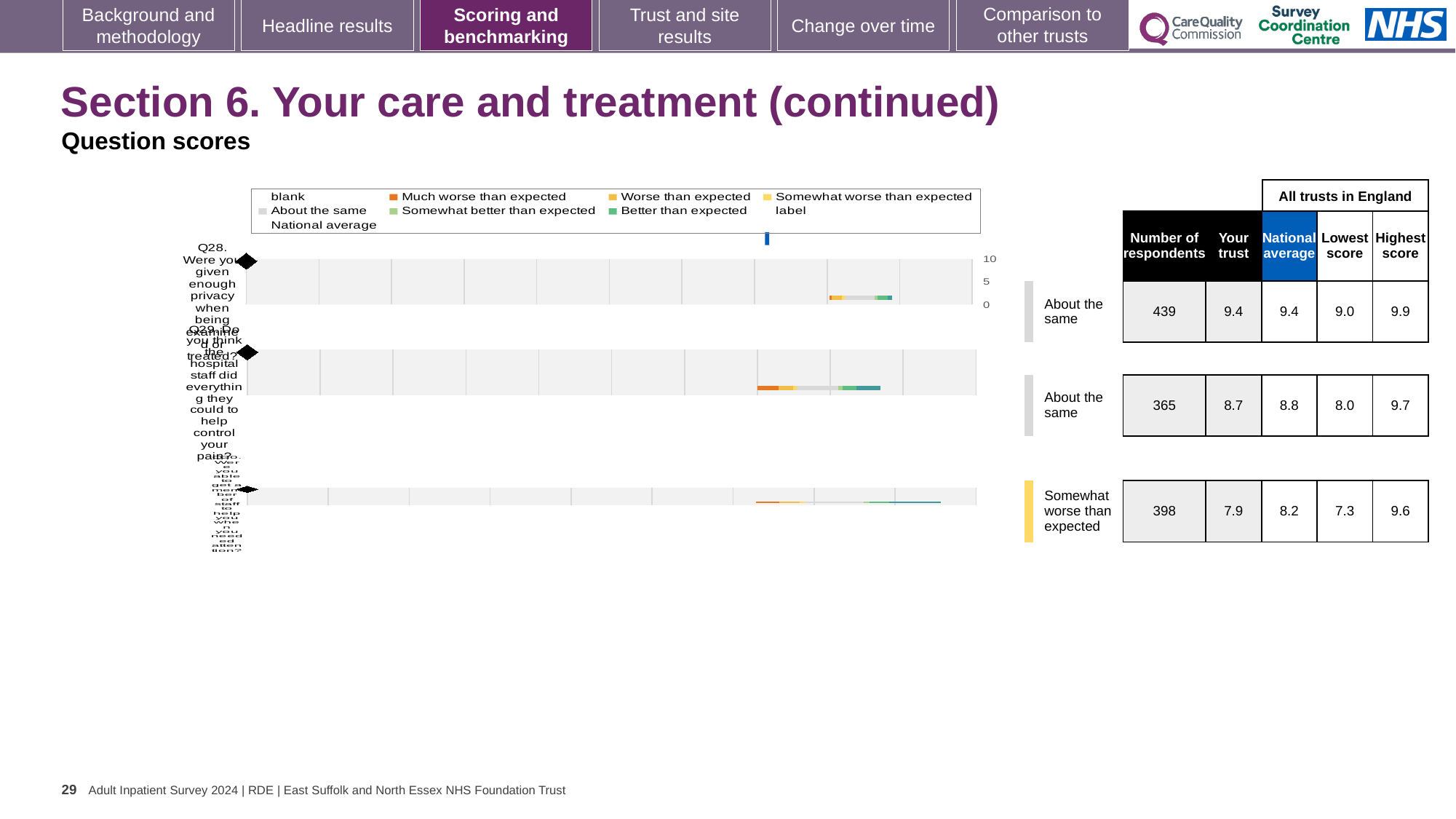
Which question row has the highest 'Your trust' score? Q28 What is the difference between the highest score and the lowest score for Q28? 0.9 How many question rows are plotted in the chart? 3 Which question row has the lowest 'Your trust' score? Q30 What is the difference between the national average and the trust score for Q30? 0.3 What is the 'Your trust' score for Q28 (privacy when being examined or treated)? 9.4 For Q29, which is larger: the trust score or the national average? National average What is the national average score for Q29 (staff did everything to help control your pain)? 8.8 What kind of chart is used to show the question scores on this slide? Bar chart How many respondents answered Q30, the third question row? 398 Which benchmark category is Q30 placed in? Somewhat worse than expected Which question row has the most respondents? Q28